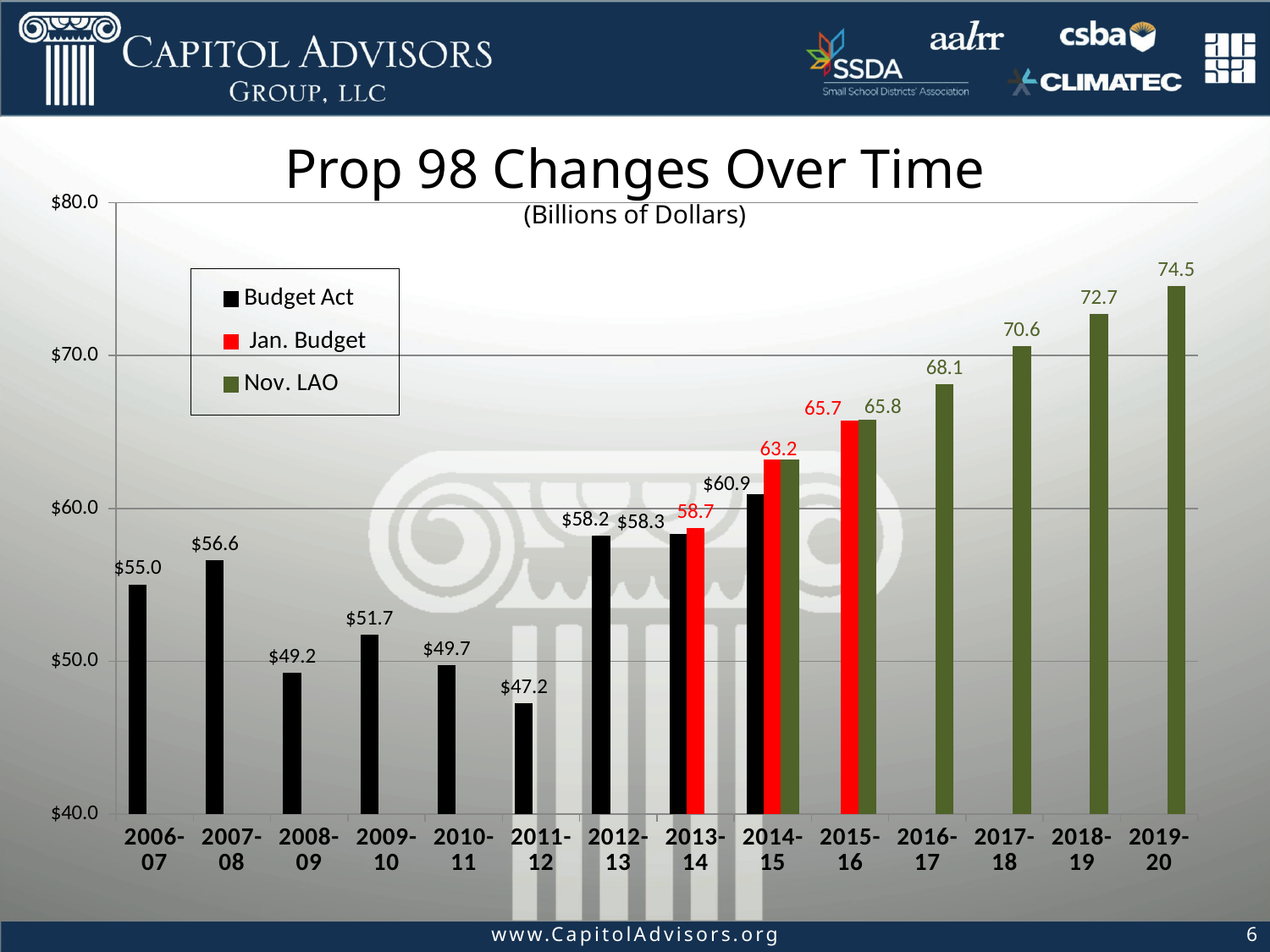
What is the Budget Act value for 2011-12? $47.2 What is the Budget Act value for 2006-07? $55.0 Which year has the larger Budget Act value, 2009-10 or 2010-11? 2009-10 Do the Nov. LAO values rise or fall from 2015-16 to 2019-20? Rise How many series does the legend list? 3 What is the difference between the Budget Act values for 2007-08 and 2006-07? $1.6 How many fiscal years are shown on the x axis? 14 What is the Nov. LAO value for 2019-20? 74.5 What kind of chart is shown on the slide? Bar chart What is the Jan. Budget value for 2015-16? 65.7 Which year has the lowest Budget Act value? 2011-12 Which year has the highest Budget Act value? 2014-15